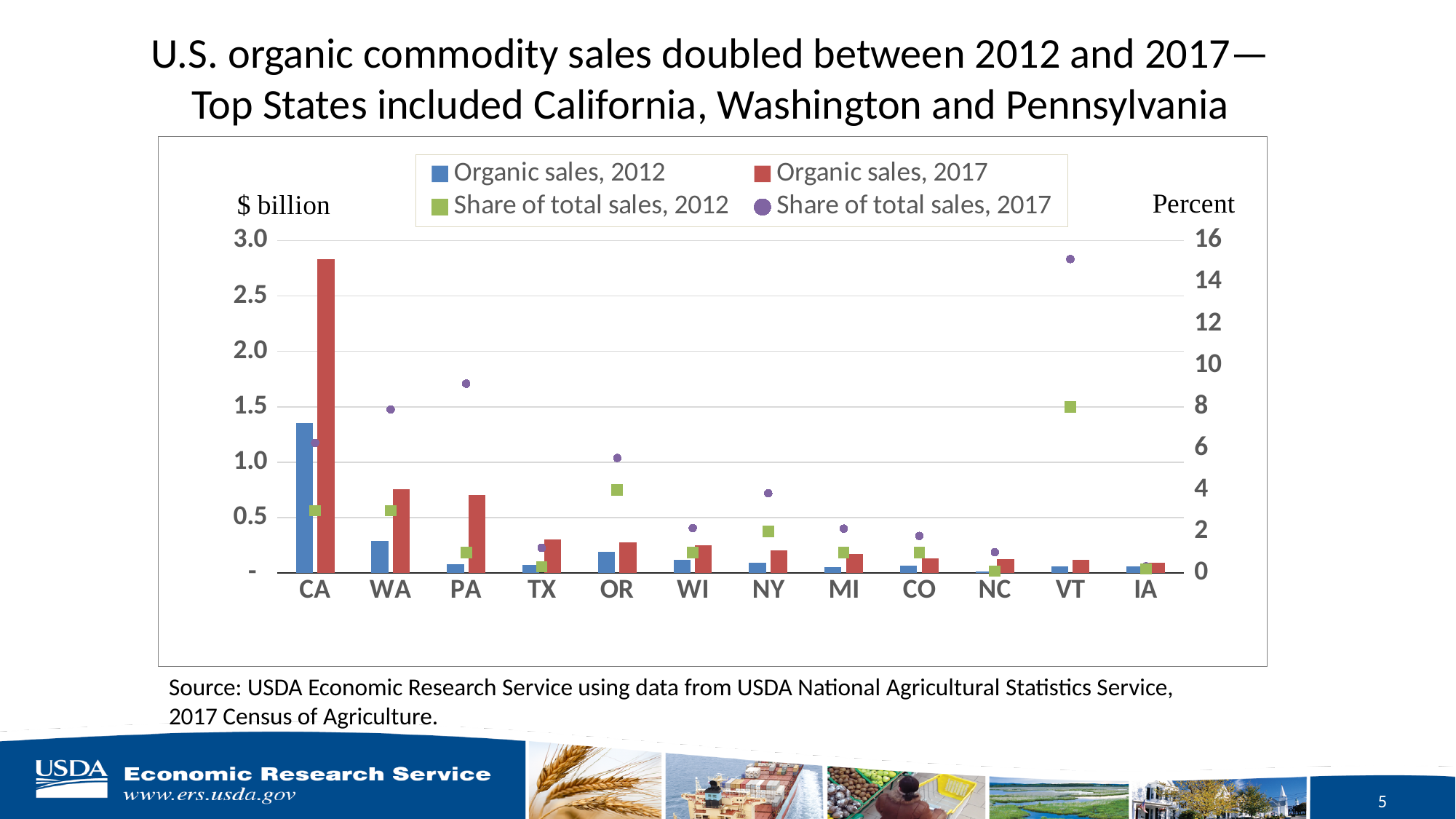
Is the value of organic sales, 2012 for CA greater or less than 1.5? less Which state has larger organic sales in 2017, WA or TX? WA What kind of chart is shown on the slide? bar chart Do the organic sales, 2017 bars generally rise or fall moving from CA to IA along the x axis? fall Which state has the highest organic sales in 2017? CA How many states are shown along the x axis of the chart? 12 Is the share of total sales, 2017 for PA greater or less than 8? greater Is the value of organic sales, 2017 for CA greater or less than 2.5? greater Which state has the highest share of total sales in 2017? VT What is the label of the right-hand vertical axis? Percent How many series does the chart's legend list? 4